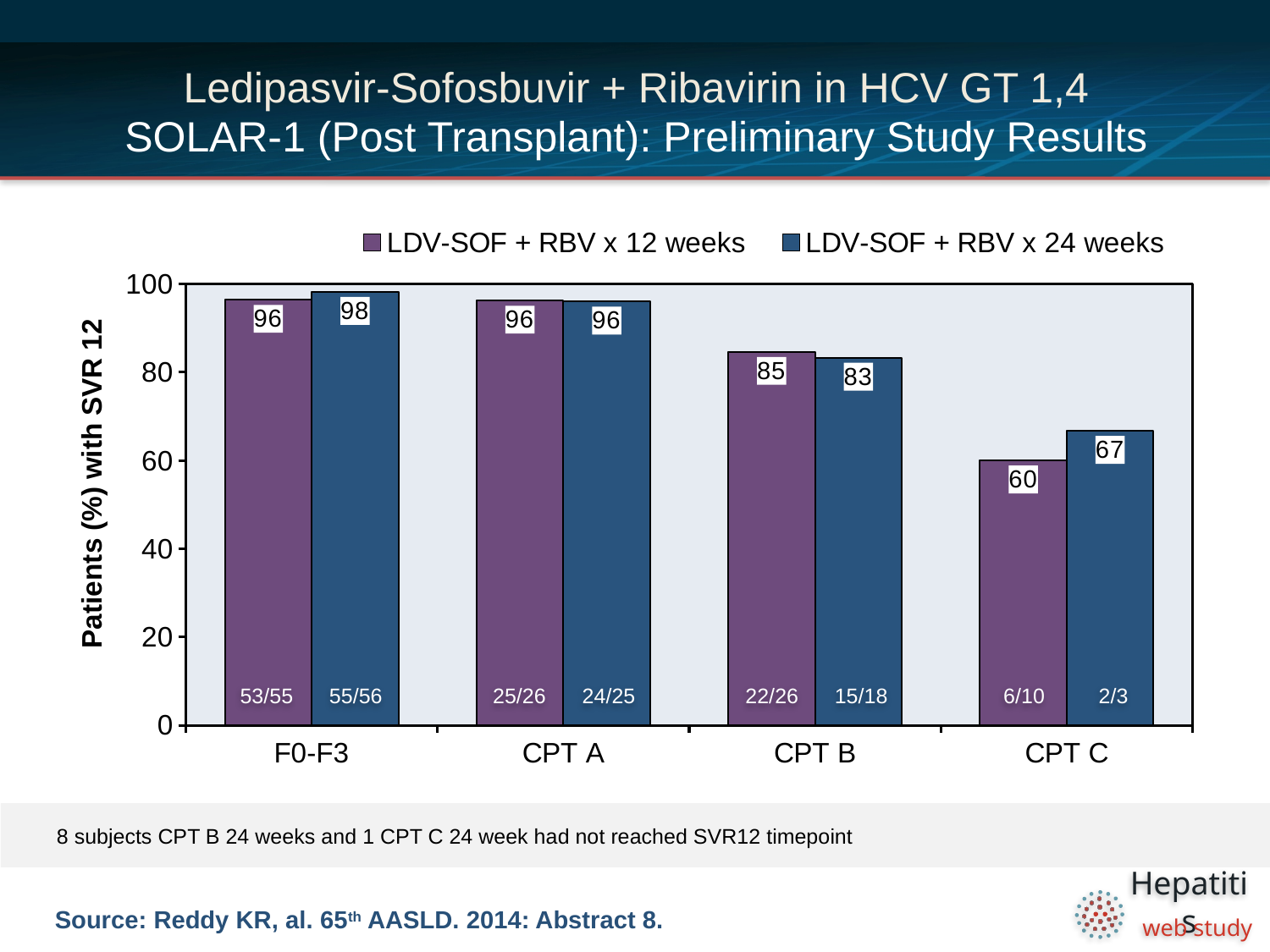
What is the patient fraction shown for the LDV-SOF + RBV x 12 weeks group in the CPT B category? 22/26 What is the SVR12 rate for the LDV-SOF + RBV x 24 weeks group in the CPT B category? 83 Which category has the highest SVR12 rate for the LDV-SOF + RBV x 24 weeks group? F0-F3 What is the label of the y axis? Patients (%) with SVR 12 What is the SVR12 rate for the LDV-SOF + RBV x 12 weeks group in the F0-F3 category? 96 What is the SVR12 rate for the LDV-SOF + RBV x 24 weeks group in the CPT C category? 67 What is the difference between the 12-week and 24-week SVR12 rates in the CPT C category? 7 How many categories are shown on the x axis? 4 In the CPT B category, which group has the higher SVR12 rate, 12 weeks or 24 weeks? LDV-SOF + RBV x 12 weeks Which category has the lowest SVR12 rate for the LDV-SOF + RBV x 12 weeks group? CPT C What kind of chart is shown on the slide? Bar chart How many series does the legend list? 2